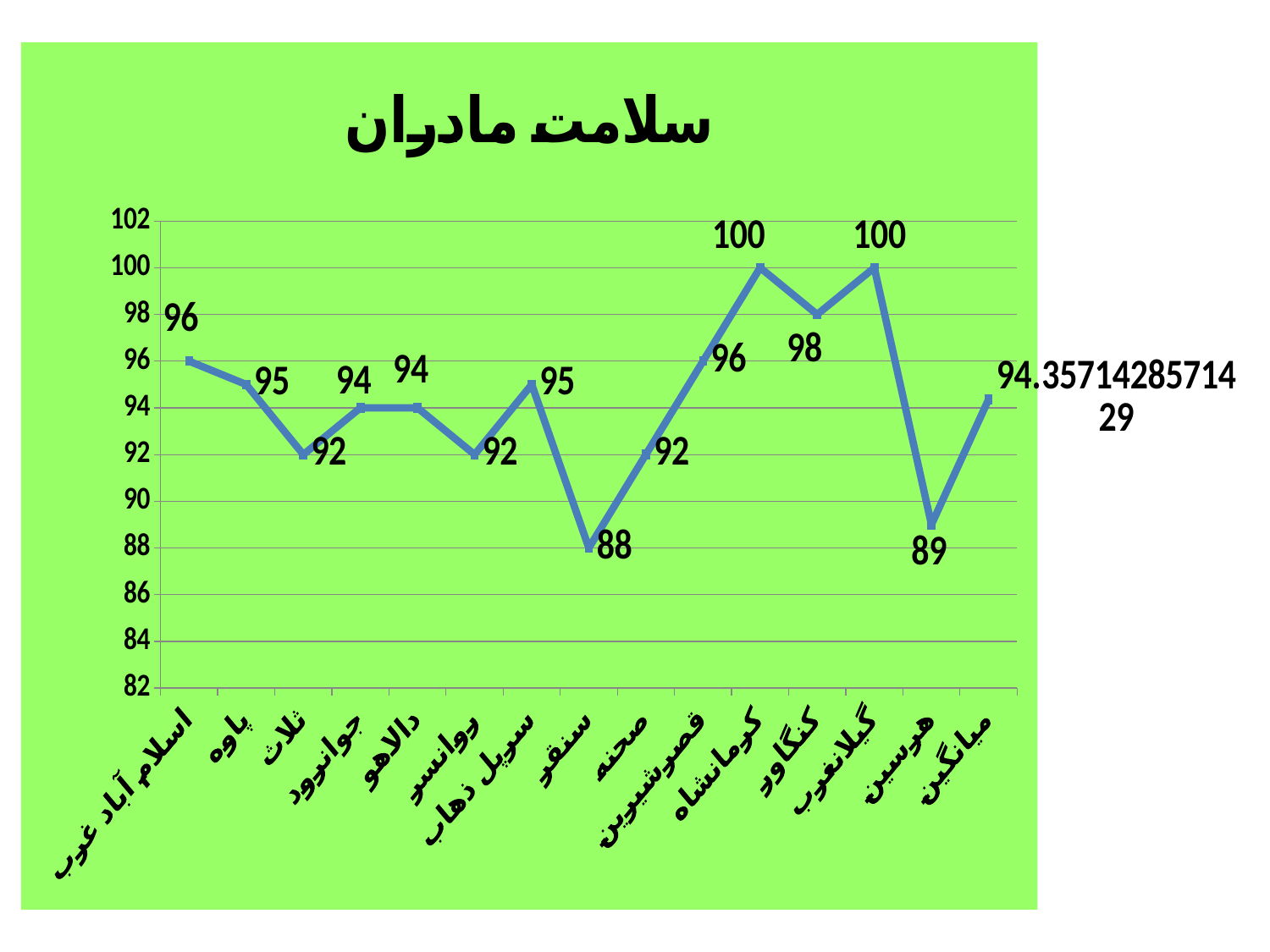
What type of chart is shown on the slide? line chart What is the value for کنگاور? 98 How many categories are plotted on the x axis? 15 Which is larger, the value for پاوه or the value for ثلاث? پاوه What is the title of the chart? سلامت مادران What is the value for هرسین? 89 Which category has the lowest value? سنقر What is the value for سنقر? 88 What is the value for اسلام آباد غرب? 96 What is the difference between the values for کرمانشاه and سنقر? 12 What is the difference between the values for گیلانغرب and هرسین? 11 Is the value for هرسین greater or less than 90? less